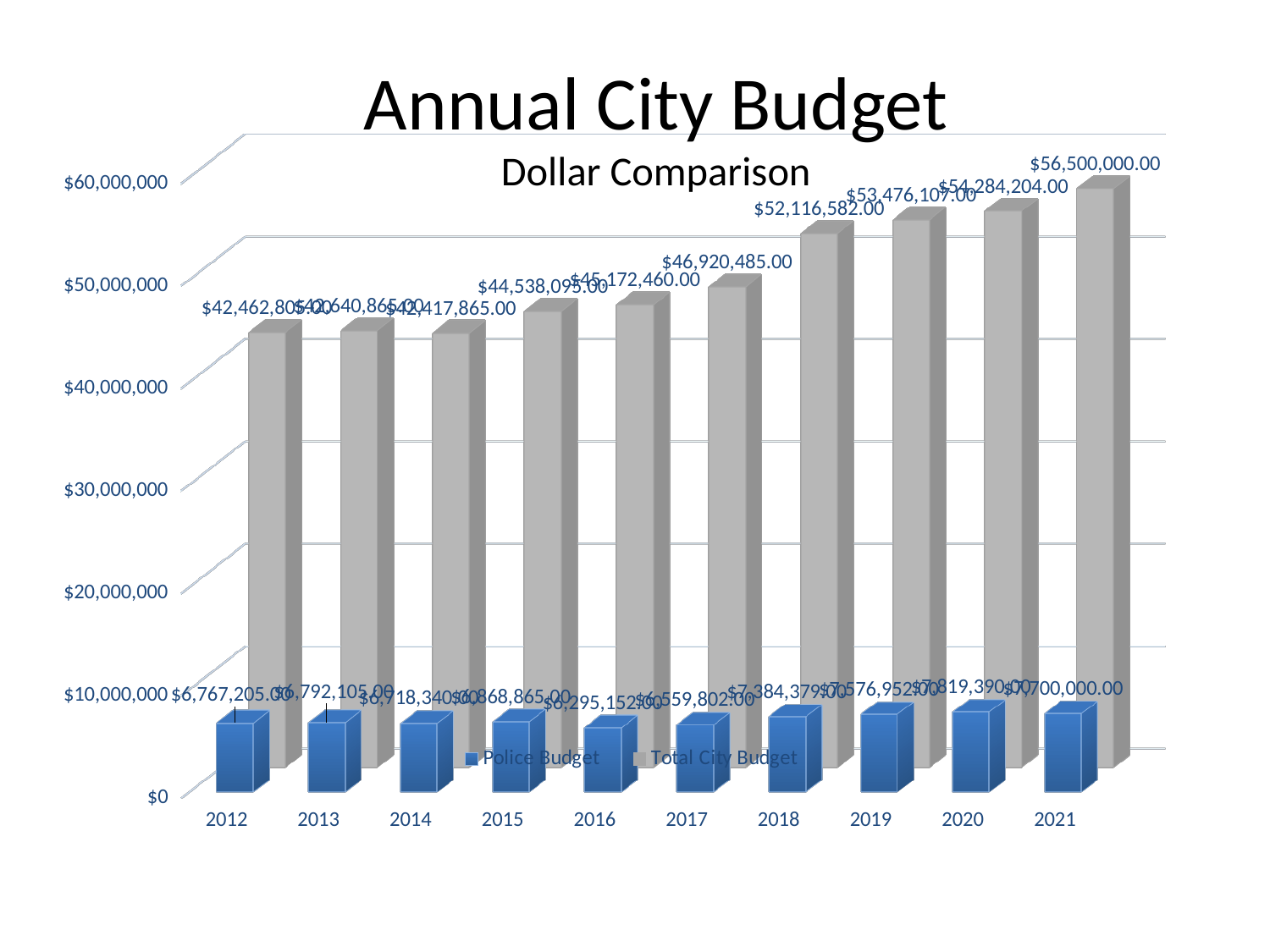
What is the Total City Budget value for 2021? $56,500,000.00 What is the Total City Budget value for 2018? $52,116,582.00 What is the difference between the Total City Budget in 2021 and in 2018? $4,383,418.00 How many series does the legend list? 2 What kind of chart is shown on the slide? bar chart What is the Police Budget value for 2021? $7,700,000.00 What is the Police Budget value for 2016? $6,295,152.00 Which is larger, the Total City Budget in 2017 or in 2019? 2019 Does the Total City Budget generally rise or fall from 2012 to 2021? rise Which year has the highest Total City Budget? 2021 Is the Total City Budget value for 2012 greater or less than $40,000,000? greater How many years are shown on the x axis? 10